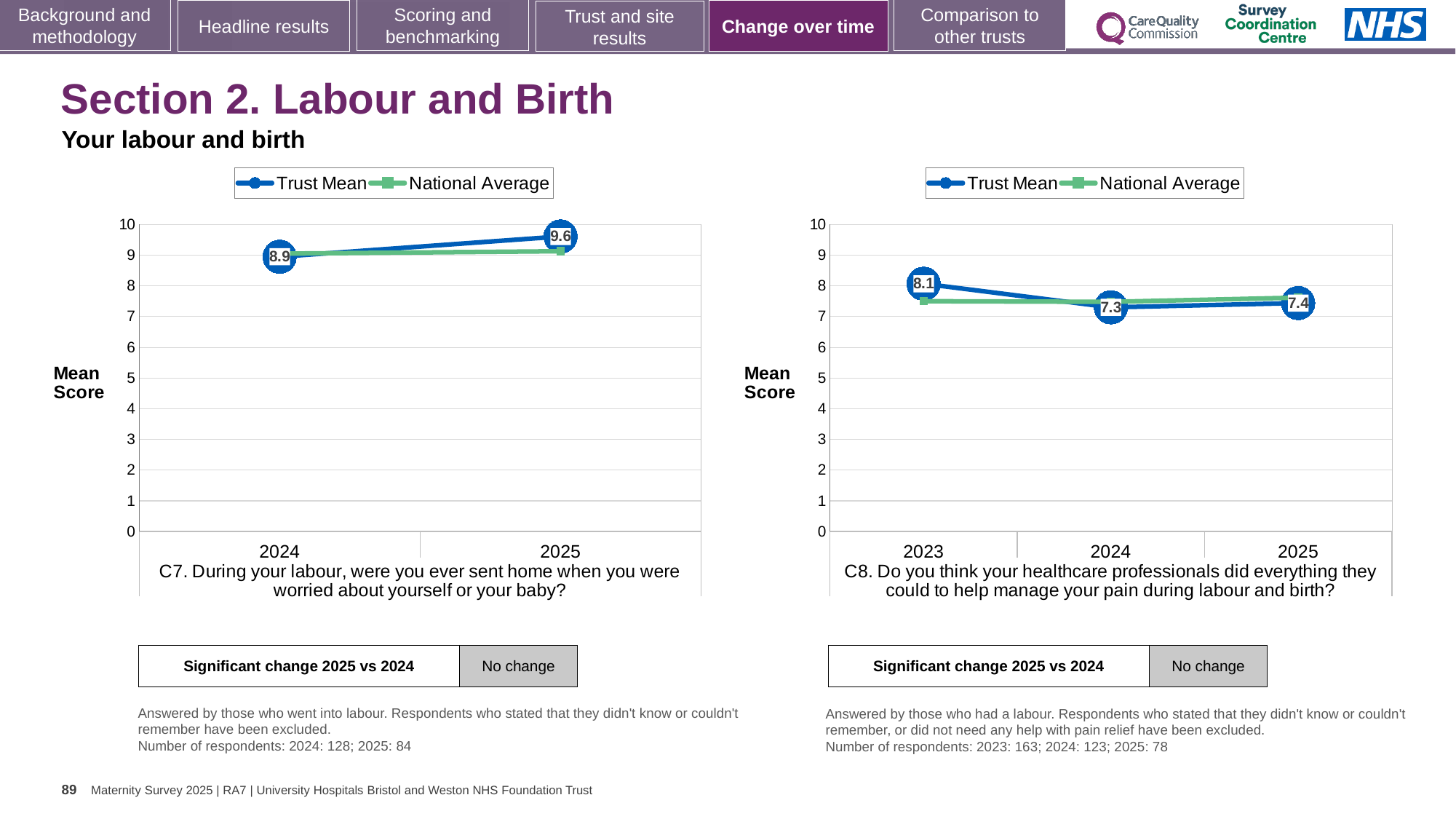
In the right chart (C8), what is the Trust Mean score for 2023? 8.1 In the left chart (C7), how many years are shown on the x axis? 2 In the right chart (C8), is the National Average for 2025 greater or less than 7? greater How many series does the legend of the right chart (C8) list? 2 In the left chart (C7), does the Trust Mean rise or fall from 2024 to 2025? rise In the left chart (C7), what is the Trust Mean score for 2024? 8.9 In the right chart (C8), which year has the lowest Trust Mean score? 2024 In the right chart (C8), which year has the highest Trust Mean score? 2023 In the right chart (C8), what is the Trust Mean score for 2024? 7.3 In the left chart (C7), what is the Trust Mean score for 2025? 9.6 In the left chart (C7), by how much did the Trust Mean change from 2024 to 2025? 0.7 In the right chart (C8), what is the difference between the Trust Mean in 2023 and 2025? 0.7